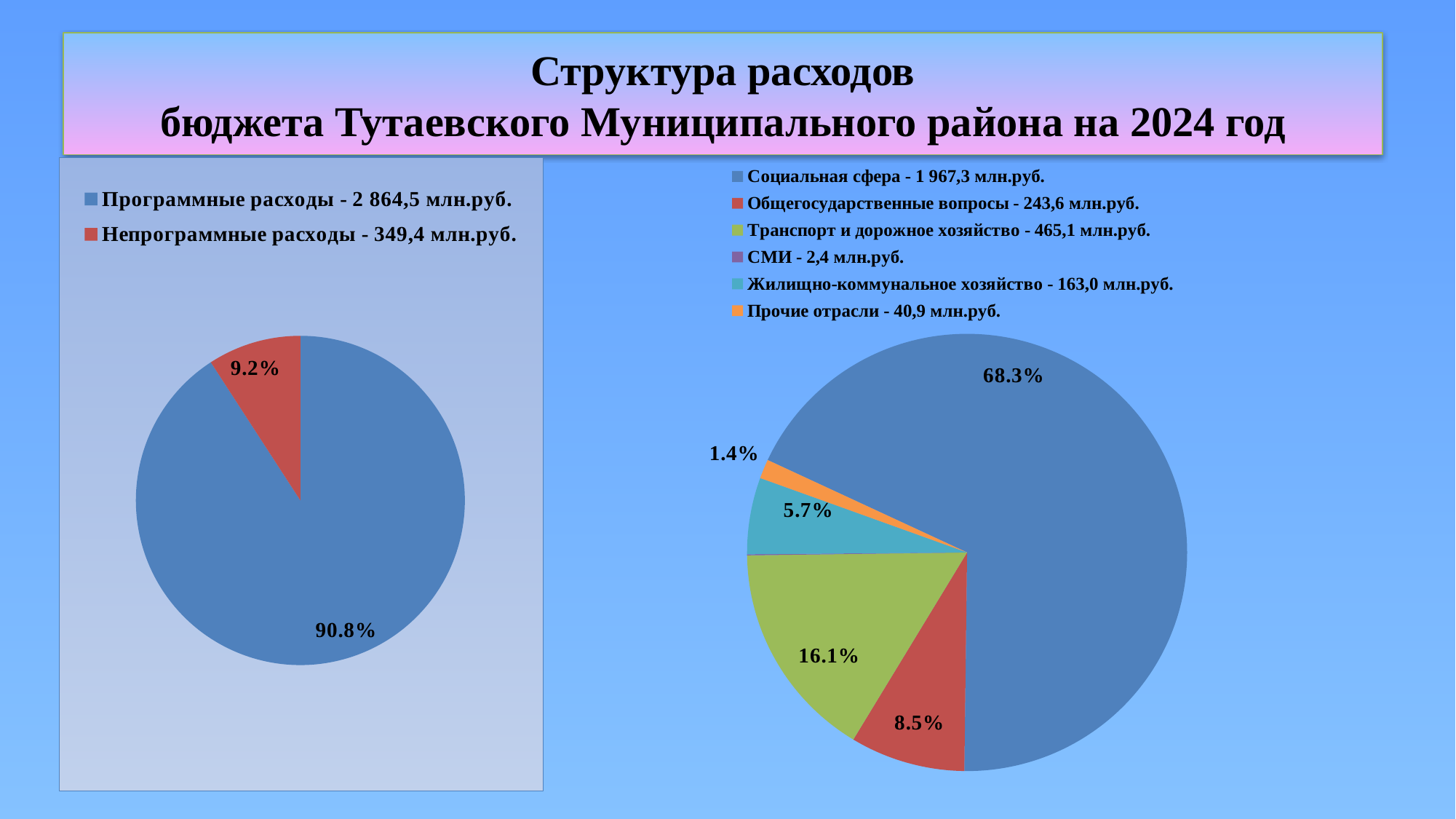
In the right pie chart, what share of the pie is Социальная сфера? 68.3% In the right pie chart, what share of the pie is Транспорт и дорожное хозяйство? 16.1% In the right pie chart, what share of the pie is Жилищно-коммунальное хозяйство? 5.7% In the left pie chart, what amount in млн.руб. does the legend give for Непрограммные расходы? 349,4 млн.руб. In the right pie chart, which category has the largest slice? Социальная сфера In the right pie chart, which slice is larger: Общегосударственные вопросы or Прочие отрасли? Общегосударственные вопросы In the right pie chart, what amount in млн.руб. does the legend give for СМИ? 2,4 млн.руб. How many categories does the legend of the right pie chart list? 6 How many entries does the legend of the left pie chart list? 2 What kind of chart is the left chart on the slide? pie chart